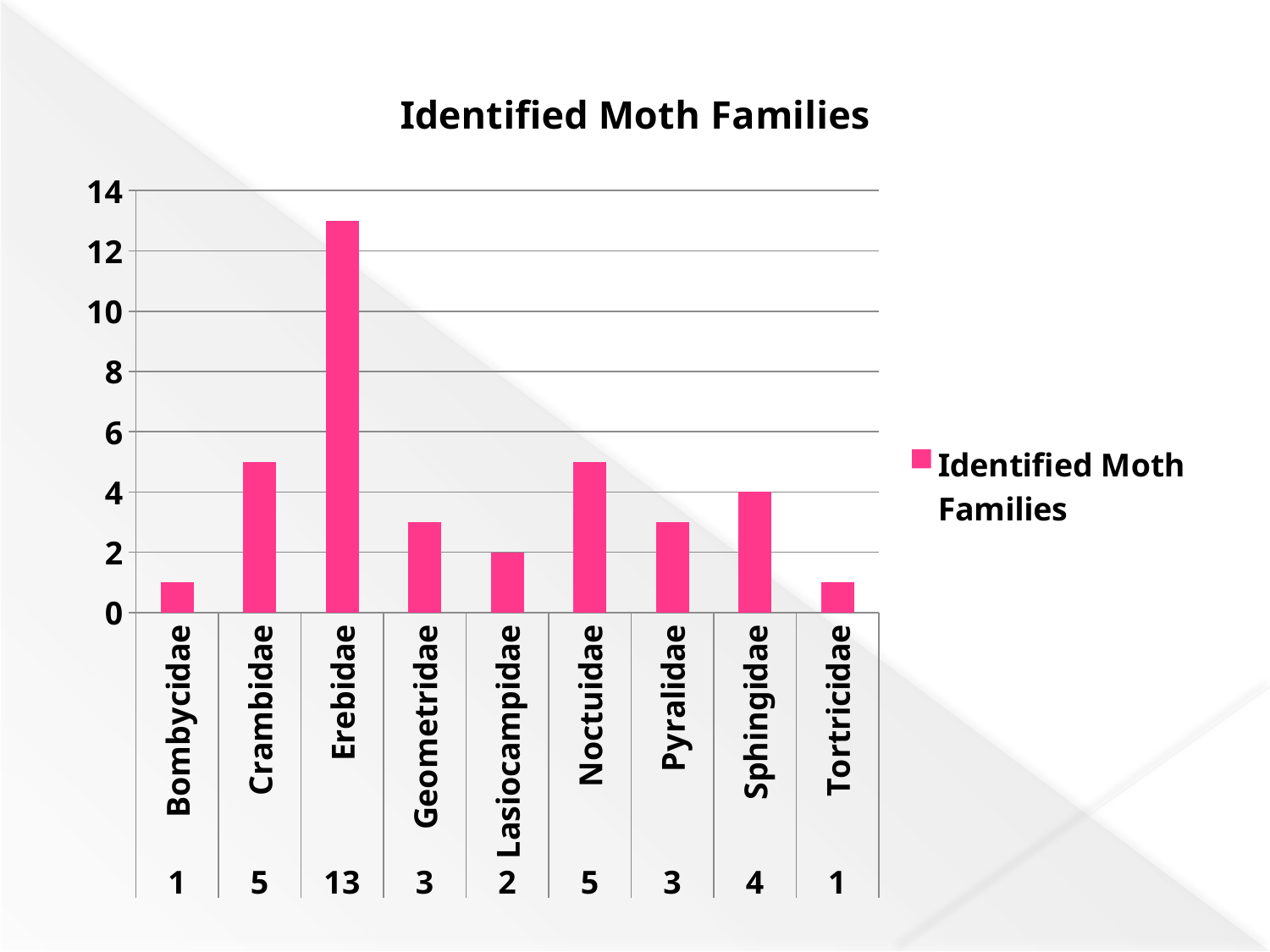
What is the value for Sphingidae? 4 Which is larger, the value for Sphingidae or the value for Geometridae? Sphingidae Is the value for Erebidae greater or less than 12? greater What is the value for Lasiocampidae? 2 What is the difference between the values for Erebidae and Crambidae? 8 Which moth family has the highest value? Erebidae What is the title of the chart? Identified Moth Families How many series does the legend list? 1 What is the value for Erebidae? 13 How many moth families are shown on the chart? 9 What is the difference between the values for Noctuidae and Pyralidae? 2 What kind of chart is shown on the slide? Bar chart